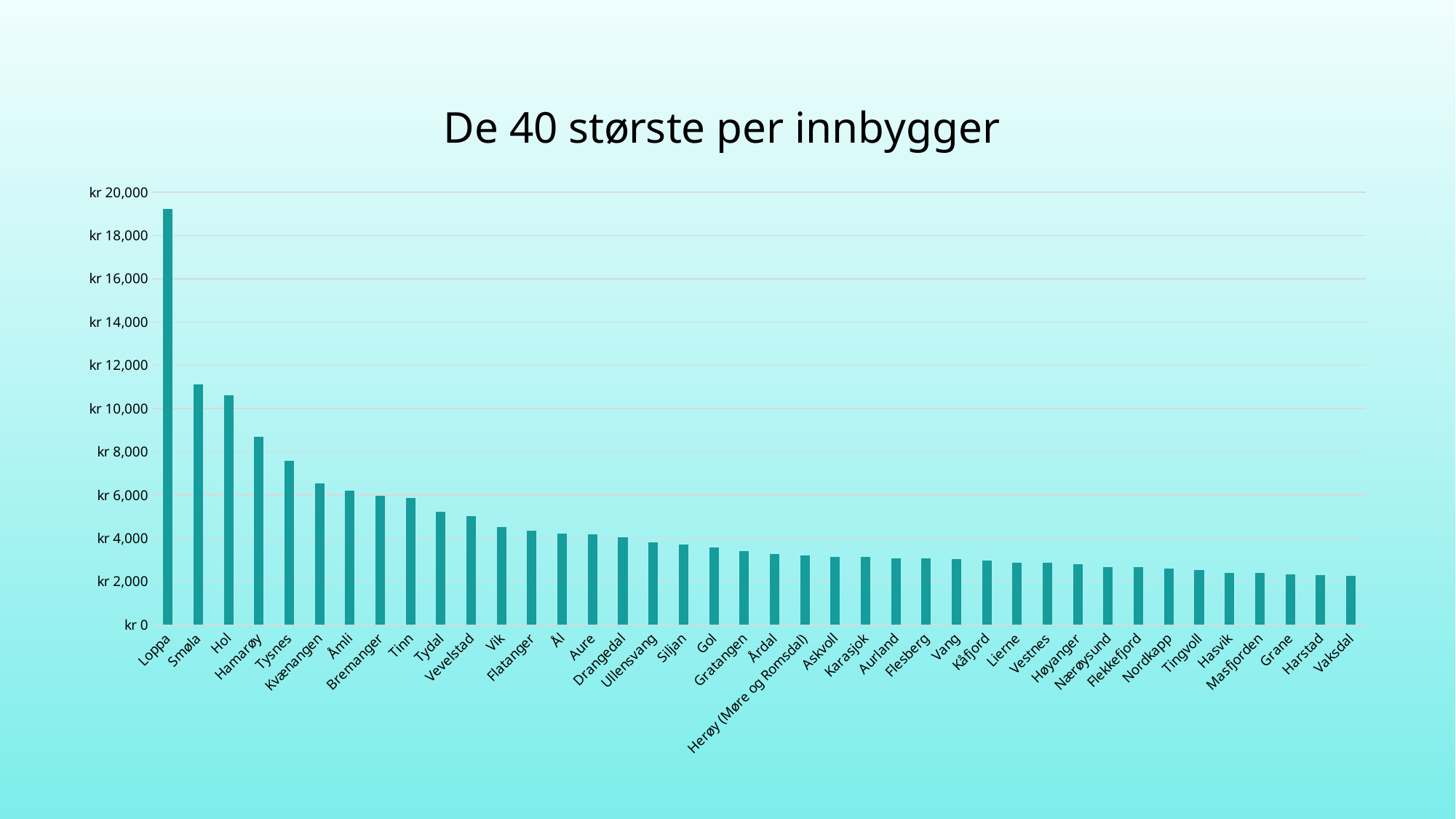
How many categories (municipalities) are plotted in the chart? 40 Is the value for Gol greater or less than kr 4,000? less What is the title of the chart? De 40 største per innbygger Which has the larger value, Loppa or Smøla? Loppa Is the value for Loppa greater or less than kr 18,000? greater Which municipality has the lowest value in the chart? Vaksdal Which has the larger value, Hamarøy or Tysnes? Hamarøy Is the value for Tysnes greater or less than kr 8,000? less What kind of chart is shown on the slide? Bar chart Which municipality has the highest value in the chart? Loppa Do the values rise or fall moving from left to right along the x axis? Fall